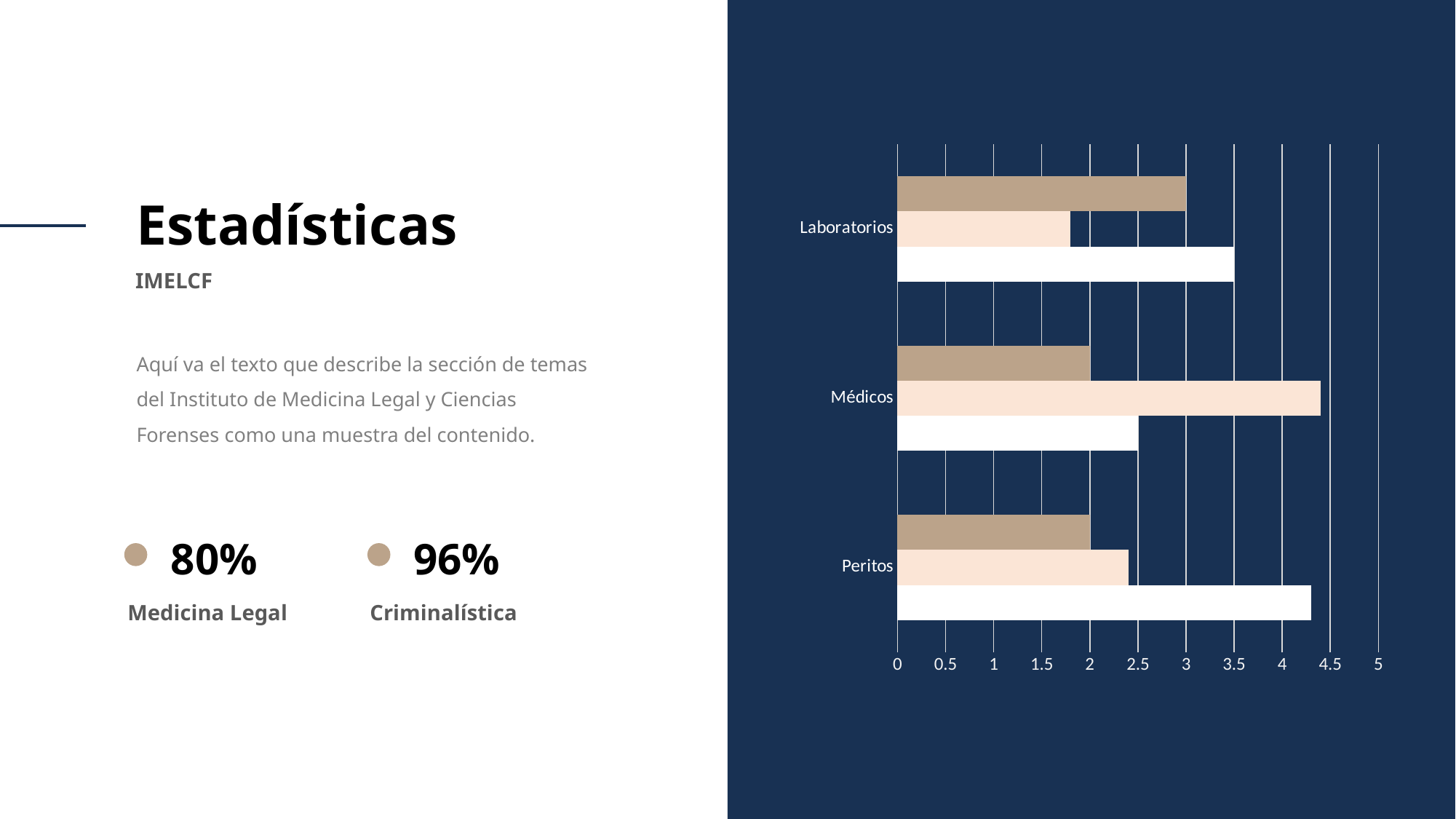
Is the value of the light peach (middle) bar for Médicos greater or less than 4? greater How many bars are plotted for each category on the chart? 3 What is the value of the white (bottom) bar for Médicos? 2.5 For Médicos, which bar is longest: the tan, the light peach, or the white one? the light peach bar Is the value of the light peach (middle) bar for Laboratorios greater or less than 2? less What is the value of the white (bottom) bar for Laboratorios? 3.5 Is the value of the white (bottom) bar for Peritos greater or less than 4? greater What kind of chart is shown on the slide? bar chart What is the value of the tan (top) bar for Laboratorios? 3 What is the value of the tan (top) bar for Médicos? 2 How many categories are shown on the chart's vertical axis? 3 What is the highest value shown on the chart's horizontal axis? 5